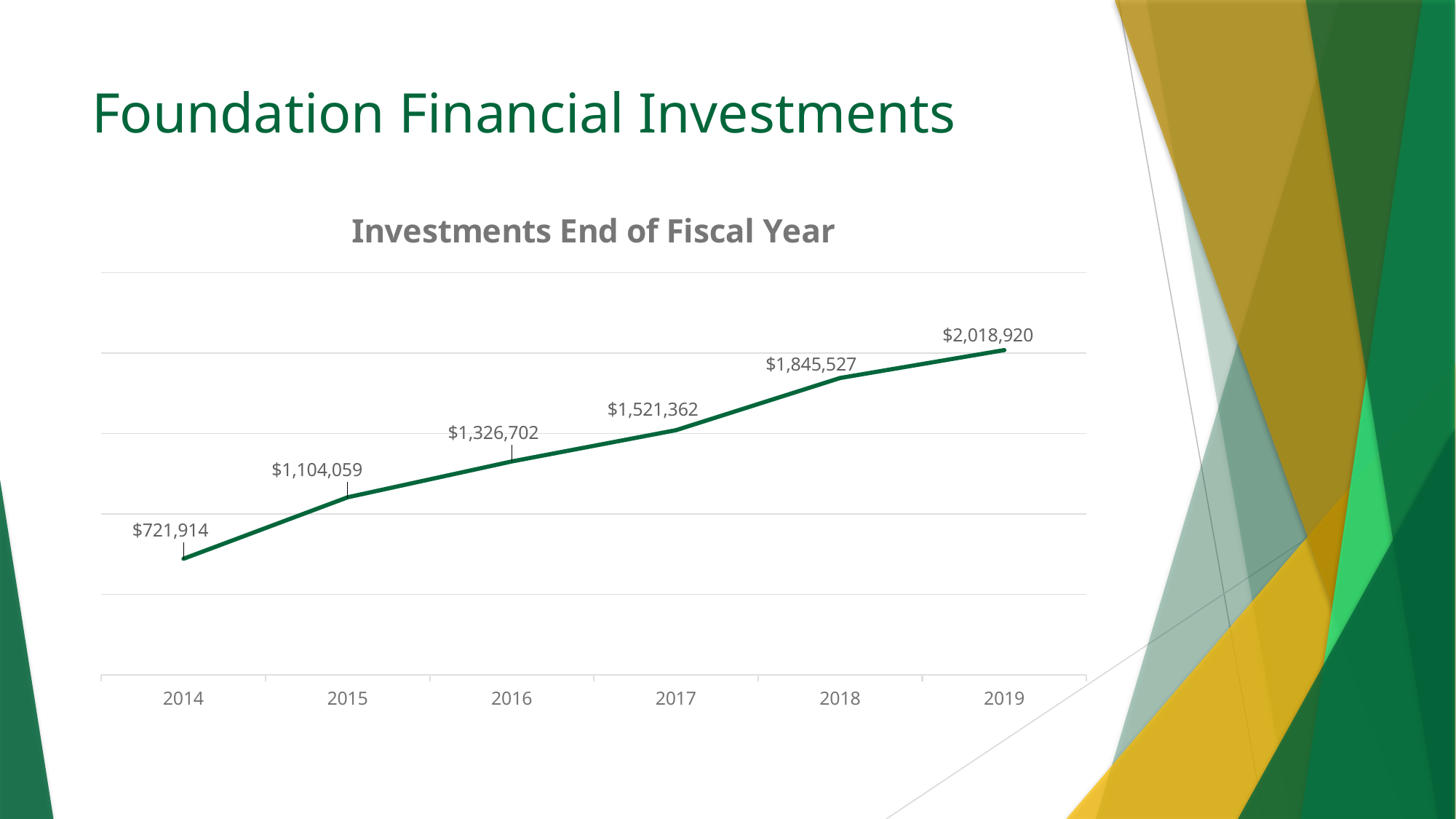
Which year has the highest investment value? 2019 What is the difference between the investment values for 2015 and 2014? $382,145 What was the value of investments at the end of fiscal year 2017? $1,521,362 What kind of chart is shown on the slide? Line chart What is the difference between the investment values for 2018 and 2017? $324,165 What was the value of investments at the end of fiscal year 2014? $721,914 Do the investment values rise or fall from 2014 to 2019? Rise What was the value of investments at the end of fiscal year 2019? $2,018,920 How many years are plotted on the chart? 6 Which year has the lowest investment value? 2014 Which year has a larger investment value, 2016 or 2018? 2018 What is the difference between the investment values for 2019 and 2014? $1,297,006